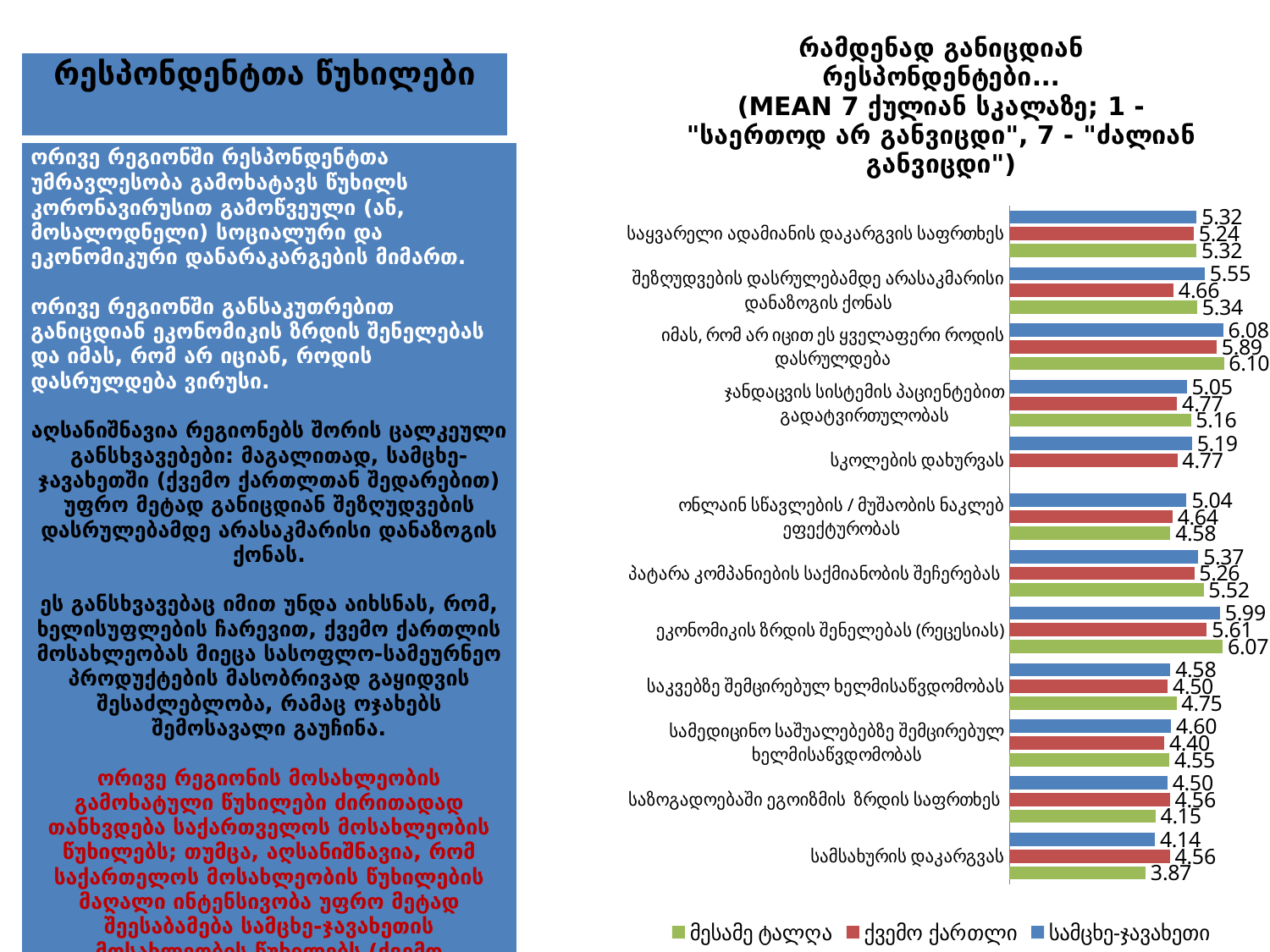
For the category "სამსახურის დაკარგვას", which series has the larger value: სამცხე-ჯავახეთი or ქვემო ქართლი? ქვემო ქართლი What is the value for სამცხე-ჯავახეთი for the category "იმას, რომ არ იცით ეს ყველაფერი როდის დასრულდება"? 6.08 Which category has the lowest value for the მესამე ტალღა series? სამსახურის დაკარგვას What is the difference between the სამცხე-ჯავახეთი and ქვემო ქართლი values for "შეზღუდვების დასრულებამდე არასაკმარისი დანაზოგის ქონას"? 0.89 For the category "საკვებზე შემცირებულ ხელმისაწვდომობას", which series has the larger value: მესამე ტალღა or ქვემო ქართლი? მესამე ტალღა How many series does the chart legend list? 3 How many categories are shown on the chart? 12 What is the value for მესამე ტალღა for the category "ეკონომიკის ზრდის შენელებას (რეცესიას)"? 6.07 Which colour represents the ქვემო ქართლი series in the chart? red Which category has the highest value for the მესამე ტალღა series? იმას, რომ არ იცით ეს ყველაფერი როდის დასრულდება What is the value for ქვემო ქართლი for the category "სამსახურის დაკარგვას"? 4.56 What type of chart is shown on the slide? bar chart